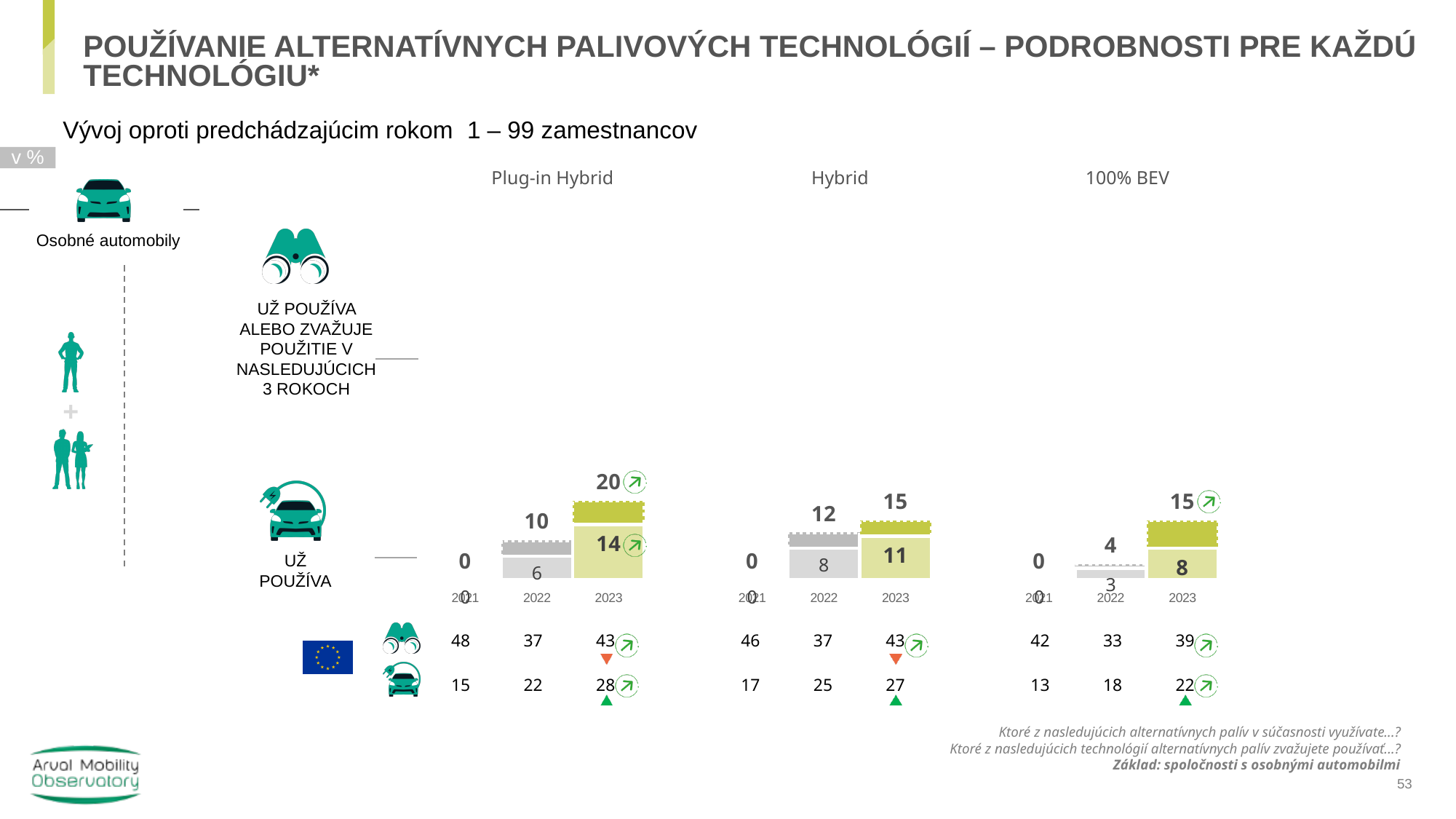
Which is larger: the 2023 'Už používa' value in the Plug-in Hybrid chart or in the 100% BEV chart? Plug-in Hybrid In the Plug-in Hybrid chart, what is the value for 'Už používa alebo zvažuje použitie v nasledujúcich 3 rokoch' in 2023? 20 In the 100% BEV chart, what is the value for 'Už používa alebo zvažuje použitie v nasledujúcich 3 rokoch' in 2022? 4 In the 100% BEV chart, what is the value for 'Už používa' in 2023? 8 In the Plug-in Hybrid chart, what is the difference between the 'Už používa' values for 2023 and 2022? 8 In the Hybrid chart, what is the difference between the 'Už používa alebo zvažuje' values for 2023 and 2022? 3 How many years are shown on the x axis of the Hybrid chart? 3 In the 100% BEV chart, do the 'Už používa' values rise or fall from 2021 to 2023? rise In the Hybrid chart, what is the value for 'Už používa' in 2022? 8 In the Plug-in Hybrid chart, what is the value for 'Už používa' (already uses) in 2023? 14 In the Hybrid chart, which year has the highest value for 'Už používa'? 2023 In the Plug-in Hybrid chart, which year has the lowest value for 'Už používa alebo zvažuje použitie v nasledujúcich 3 rokoch'? 2021